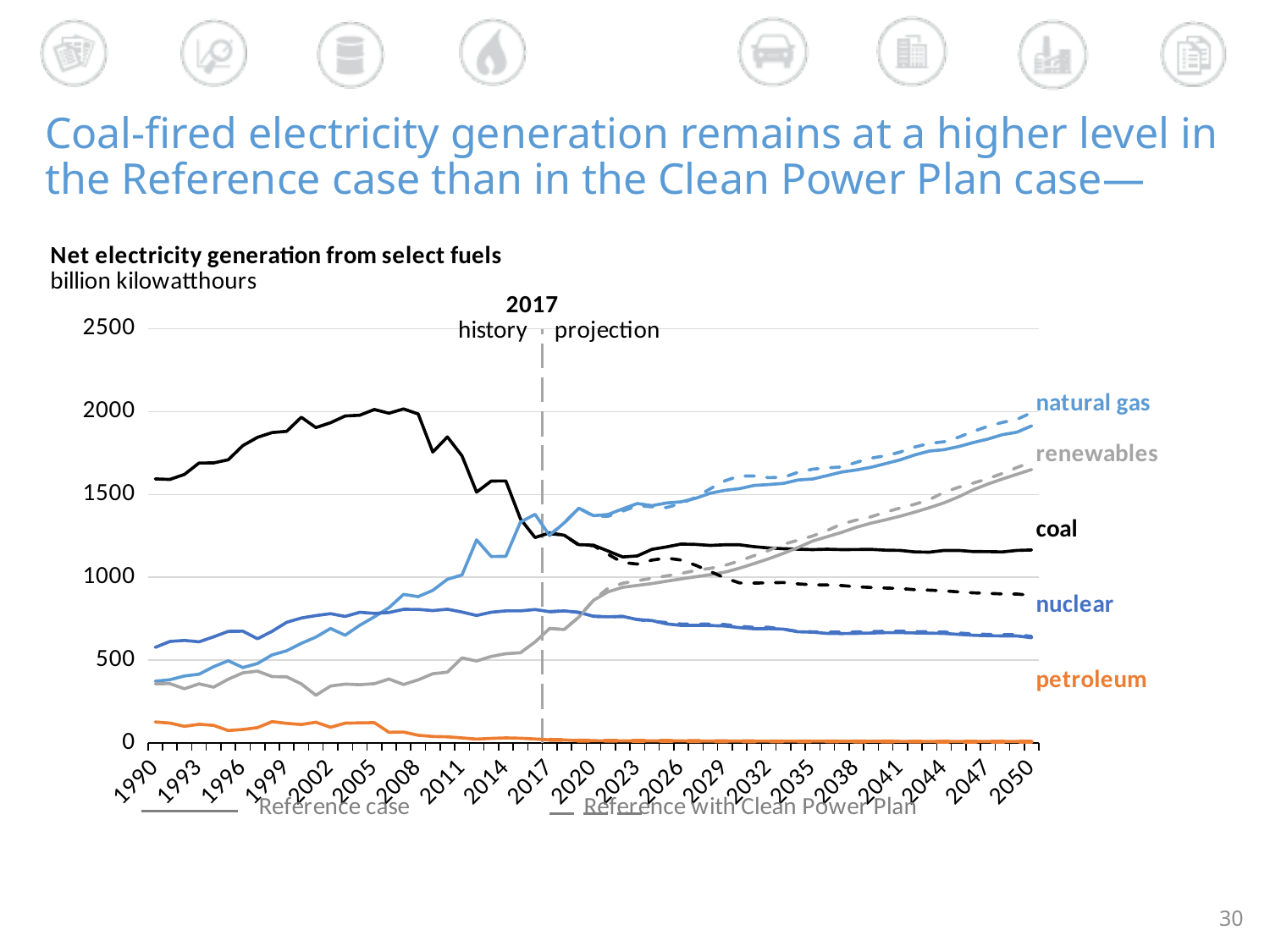
In 2050, which is larger in the Reference case: natural gas or coal? natural gas What kind of chart is shown on the slide? line chart Which fuel has the highest net electricity generation in 2050? natural gas Does petroleum generation rise or fall from 1990 to 2050? fall What year marks the boundary between history and projection on the chart? 2017 Is the value for nuclear in 2050 greater or less than 500? greater Which fuel has the lowest net electricity generation in 2050? petroleum Is the value for coal in the Reference with Clean Power Plan case in 2050 greater or less than 1000? less Does renewables generation rise or fall from 2017 to 2050? rise How many fuels are plotted on the chart? 5 Is the value for coal in 1990 greater or less than 1500? greater Which fuel has the highest net electricity generation in 1990? coal